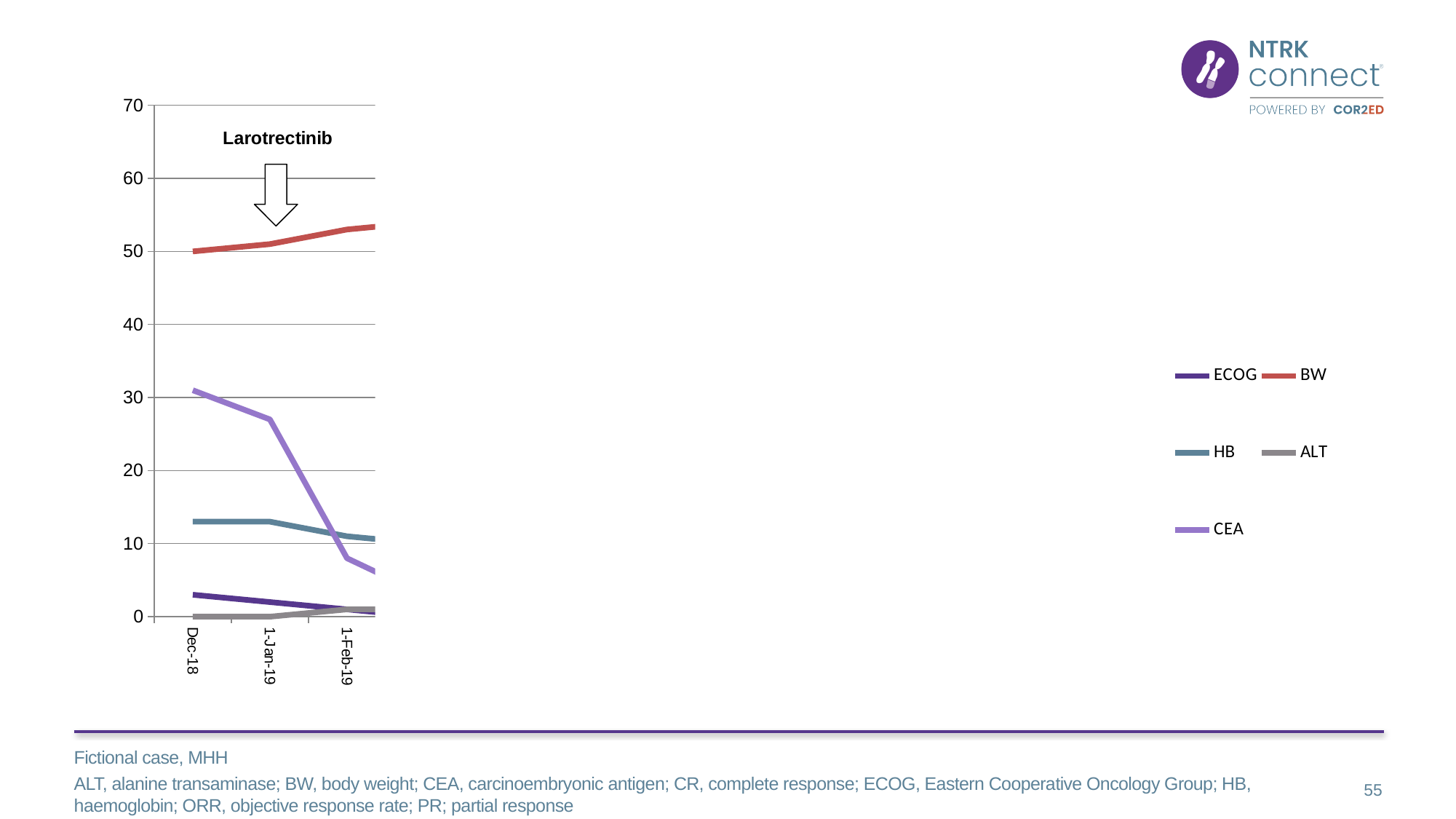
Is the value for BW at 1-Feb-19 greater or less than 50? greater At Dec-18, which is larger, CEA or HB? CEA How many series does the legend list? 5 Does the CEA line rise or fall from Dec-18 to 1-Feb-19? fall Is the value for HB at Dec-18 greater or less than 10? greater What kind of chart is shown on the slide? line chart Is the value for CEA at 1-Feb-19 greater or less than 10? less Does the BW line rise or fall from Dec-18 to 1-Feb-19? rise Which series has the highest value at Dec-18? BW Which drug name is annotated with an arrow on the chart? Larotrectinib Which series has the lowest value at Dec-18? ALT